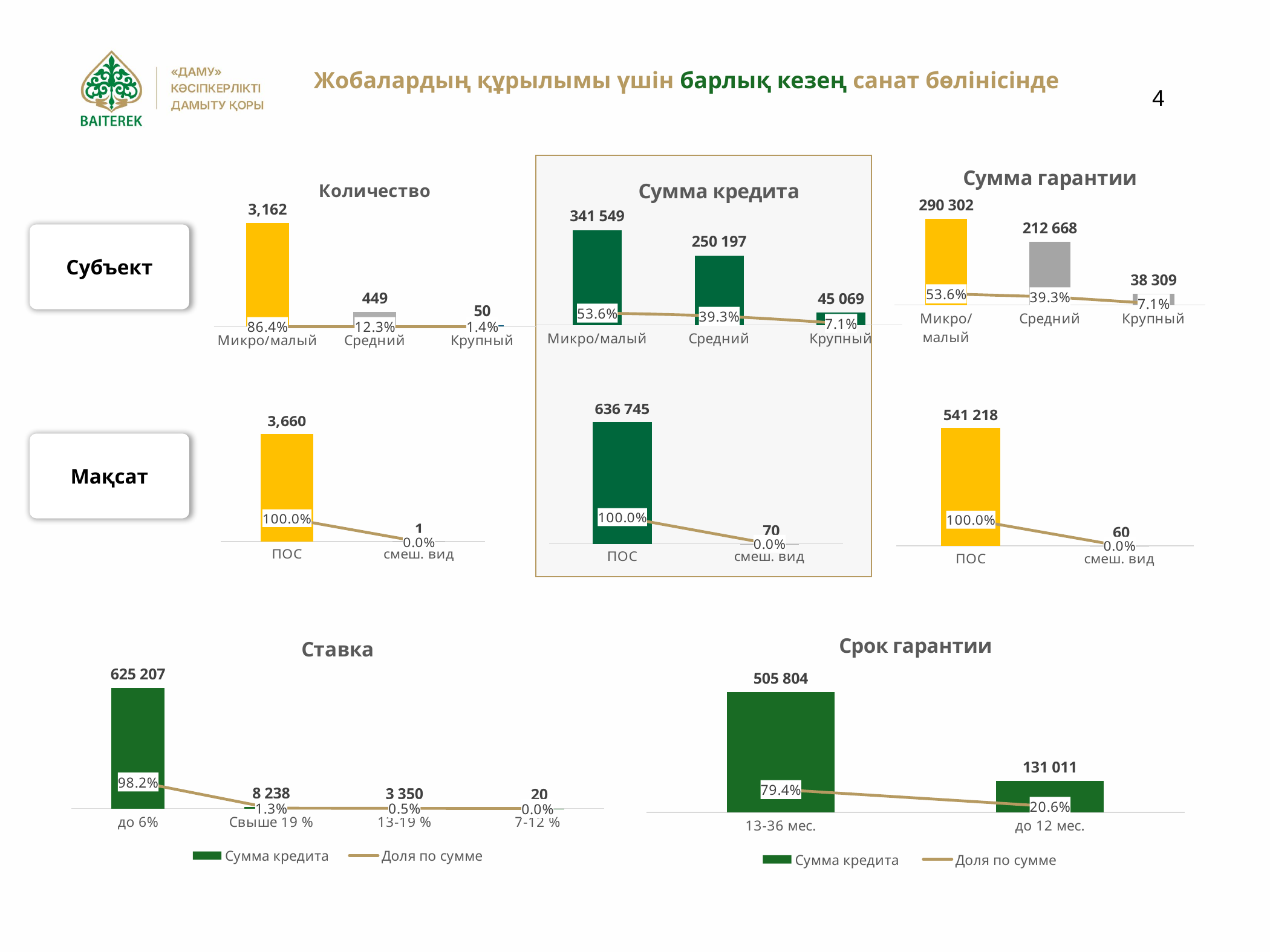
In the 'Сумма гарантии' chart in the Субъект row, which category has the lowest value? Крупный In the 'Количество' chart in the Субъект row, what is the value for Микро/малый? 3,162 In the 'Сумма гарантии' chart in the Субъект row, what share is shown for Микро/малый? 53.6% In the 'Ставка' chart, what is the value for Свыше 19 %? 8 238 In the 'Сумма кредита' chart in the Мақсат row, what is the value for ПОС? 636 745 How many series does the legend of the 'Срок гарантии' chart list? 2 In the 'Срок гарантии' chart, what share is shown for до 12 мес.? 20.6% In the 'Срок гарантии' chart, which category has the higher value: 13-36 мес. or до 12 мес.? 13-36 мес. In the 'Сумма гарантии' chart in the Мақсат row, what is the value for смеш. вид? 60 In the 'Ставка' chart, how many categories are shown on the x axis? 4 In the 'Сумма кредита' chart in the Субъект row, what is the difference between the values for Микро/малый and Средний? 91 352 In the 'Сумма кредита' chart in the Субъект row, what is the value for Средний? 250 197